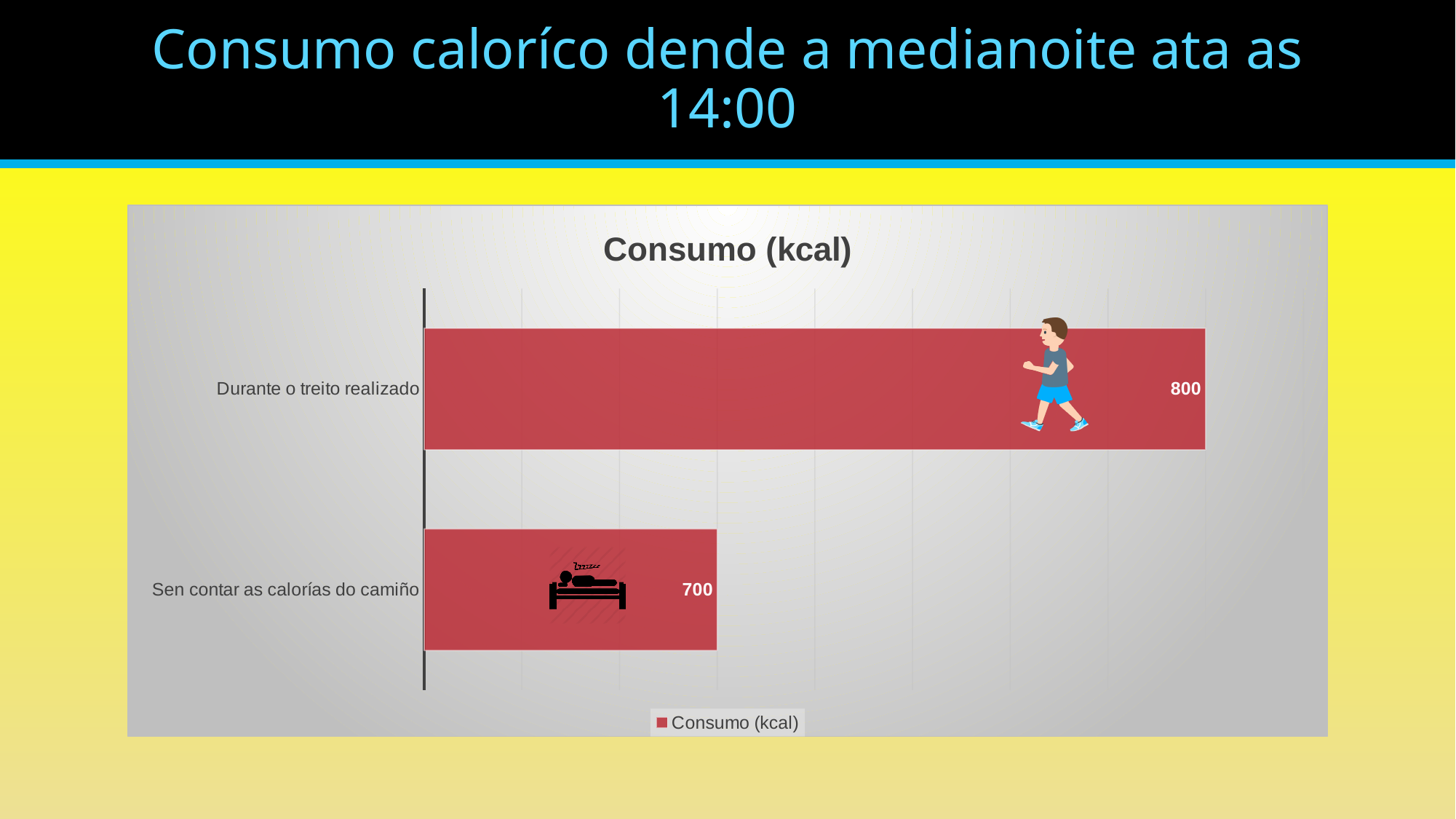
How many categories are shown in the chart? 2 Which category has the highest value? Durante o treito realizado Which is larger: the value for "Durante o treito realizado" or for "Sen contar as calorías do camiño"? Durante o treito realizado What kind of chart is shown on the slide? Bar chart What is the difference between the values for "Durante o treito realizado" and "Sen contar as calorías do camiño"? 100 What series name is listed in the legend? Consumo (kcal) What is the value for "Durante o treito realizado"? 800 Which category has the lowest value? Sen contar as calorías do camiño What is the value for "Sen contar as calorías do camiño"? 700 How many series does the legend list? 1 What is the title of the chart? Consumo (kcal)